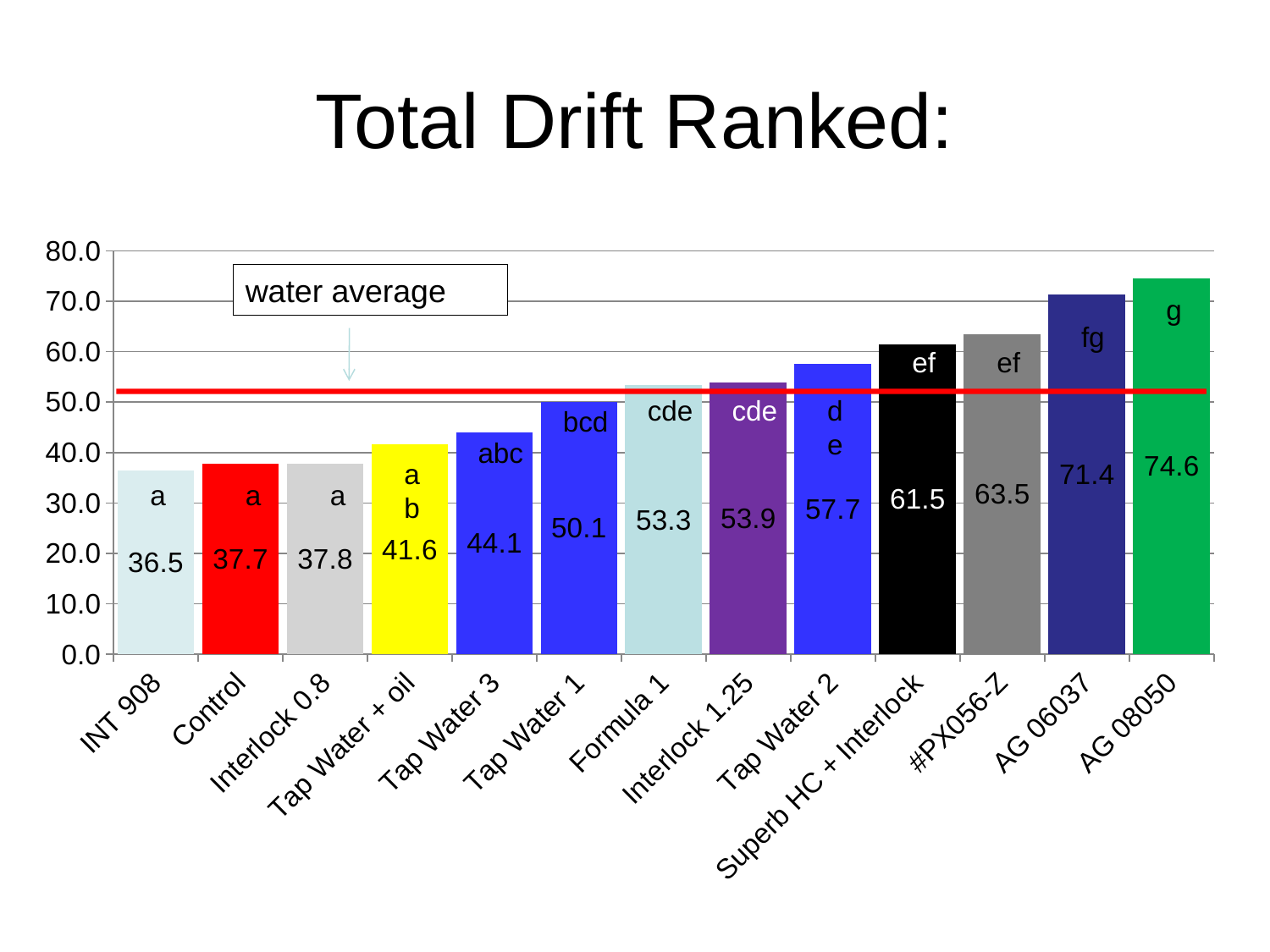
What is the value for Superb HC + Interlock? 61.5 What kind of chart is this? bar chart Which category has the lowest value? INT 908 Which is larger, the value for Tap Water 2 or the value for Formula 1? Tap Water 2 Is the value for AG 06037 greater or less than 70.0? greater What is the value for Control? 37.7 Which category has the highest value? AG 08050 What is the value for Tap Water 1? 50.1 What does the red horizontal line represent? water average What is the difference between the values for AG 08050 and INT 908? 38.1 How many categories are shown on the x axis? 13 Do the values rise or fall from left to right along the x axis? rise